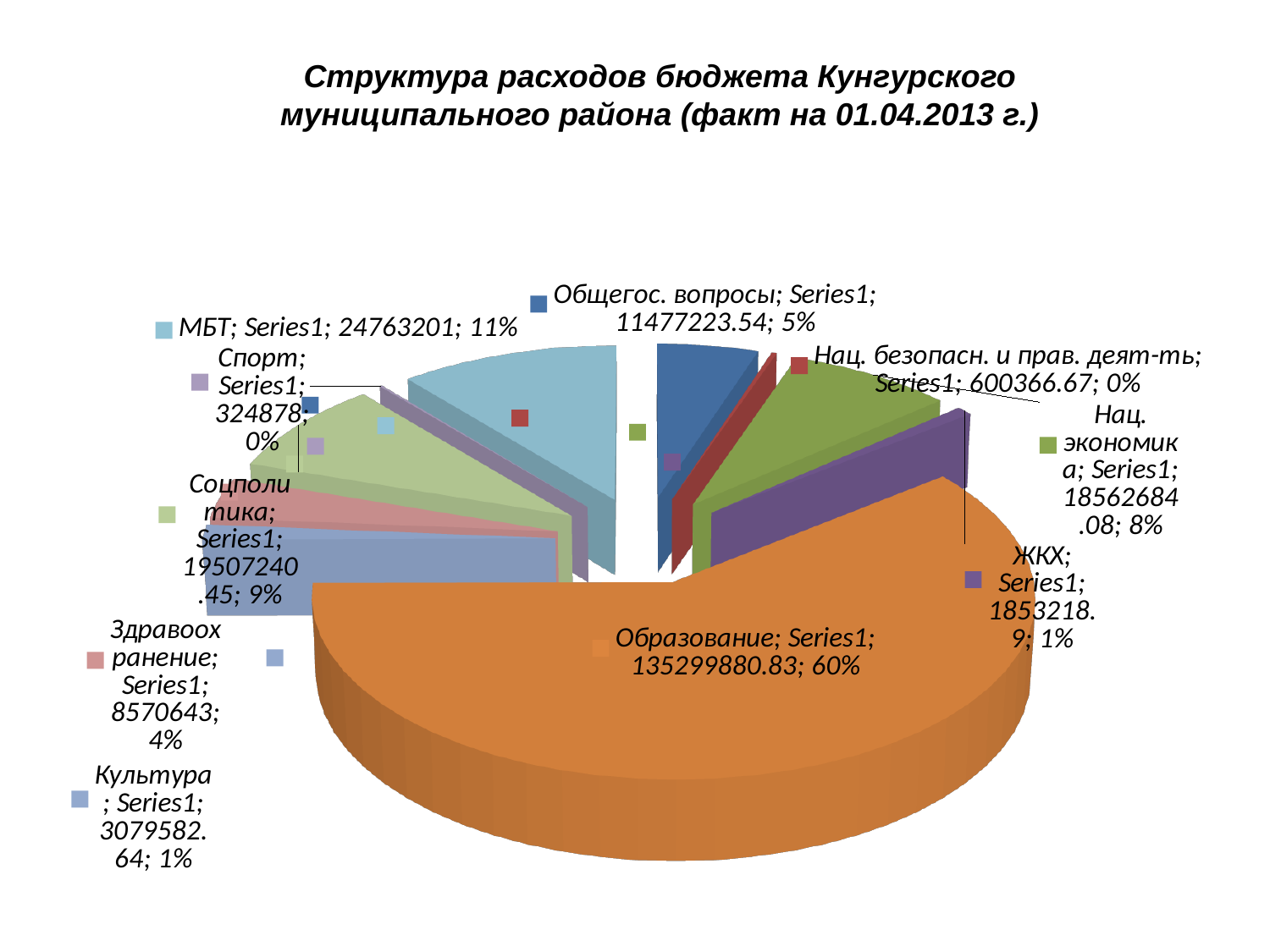
Which category has the largest slice of the pie? Образование Which is larger, the value for Нац. экономика or the value for Общегос. вопросы? Нац. экономика Which category has the smallest value in the pie chart? Спорт What is the value shown for Образование? 135299880.83 What kind of chart is shown on the slide? pie chart What is the title of the chart? Структура расходов бюджета Кунгурского муниципального района (факт на 01.04.2013 г.) What is the difference between the value for Здравоохранение and the value for Культура? 5491060.36 What share of the pie does Образование represent? 60% How many categories (slices) does the pie chart show? 10 What share of the pie does Соцполитика represent? 9% What share of the pie does ЖКХ represent? 1% What is the value shown for МБТ? 24763201